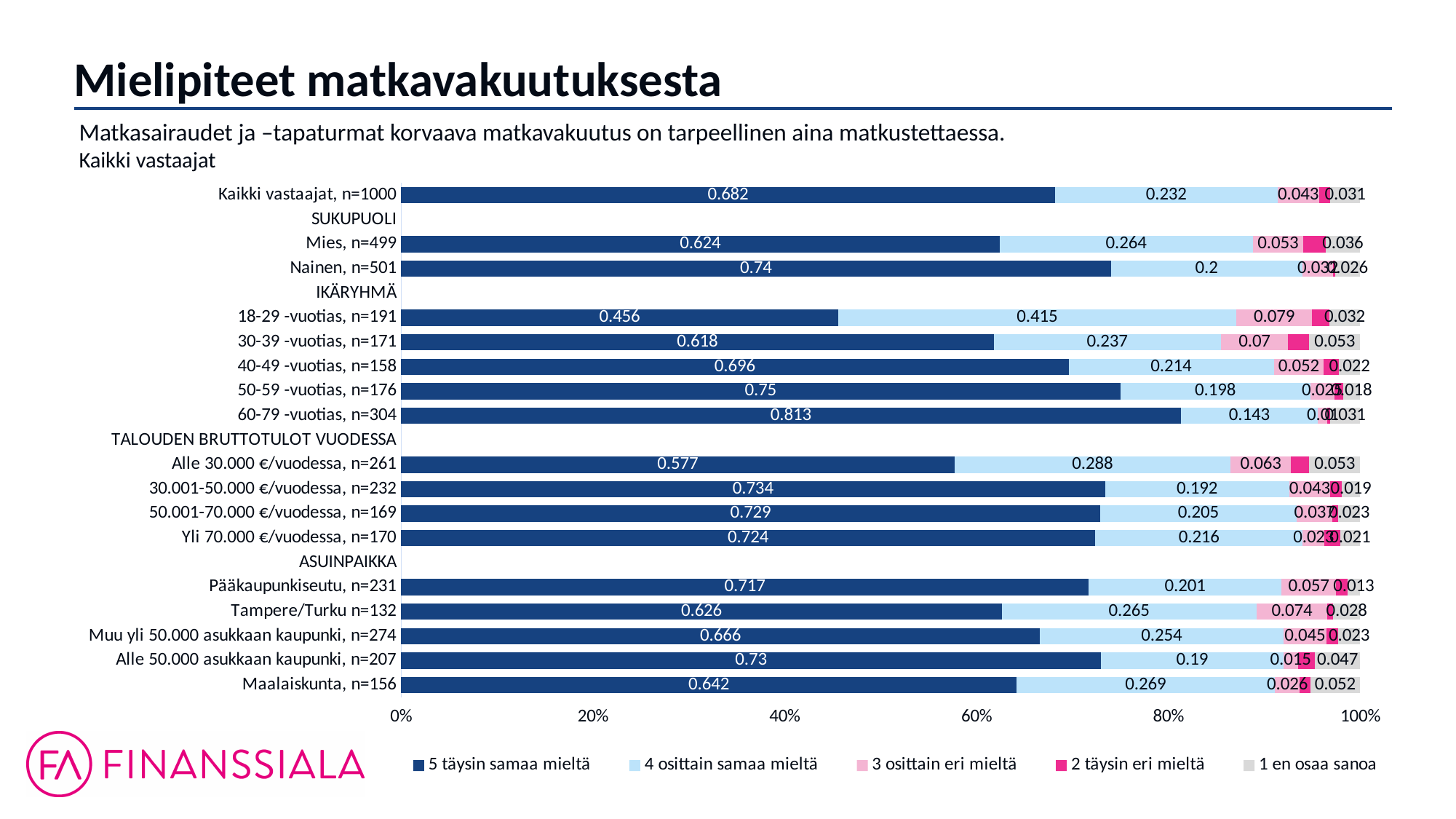
What is the value of "5 täysin samaa mieltä" for "Kaikki vastaajat, n=1000"? 0.682 How many series does the legend list? 5 Which category has the highest value for "5 täysin samaa mieltä"? 60-79 -vuotias, n=304 Which has a larger "5 täysin samaa mieltä" value: "Pääkaupunkiseutu, n=231" or "Tampere/Turku n=132"? Pääkaupunkiseutu, n=231 What is the value of "4 osittain samaa mieltä" for "Maalaiskunta, n=156"? 0.269 What is the difference between the "5 täysin samaa mieltä" values for "Nainen, n=501" and "Mies, n=499"? 0.116 How many bars (respondent groups) are plotted in the chart? 17 What is the value of "5 täysin samaa mieltä" for "Alle 30.000 €/vuodessa, n=261"? 0.577 What kind of chart is shown on the slide? Stacked bar chart What is the value of "4 osittain samaa mieltä" for "18-29 -vuotias, n=191"? 0.415 Is the "5 täysin samaa mieltä" value for "60-79 -vuotias, n=304" greater or less than 80%? greater Which category has the lowest value for "5 täysin samaa mieltä"? 18-29 -vuotias, n=191